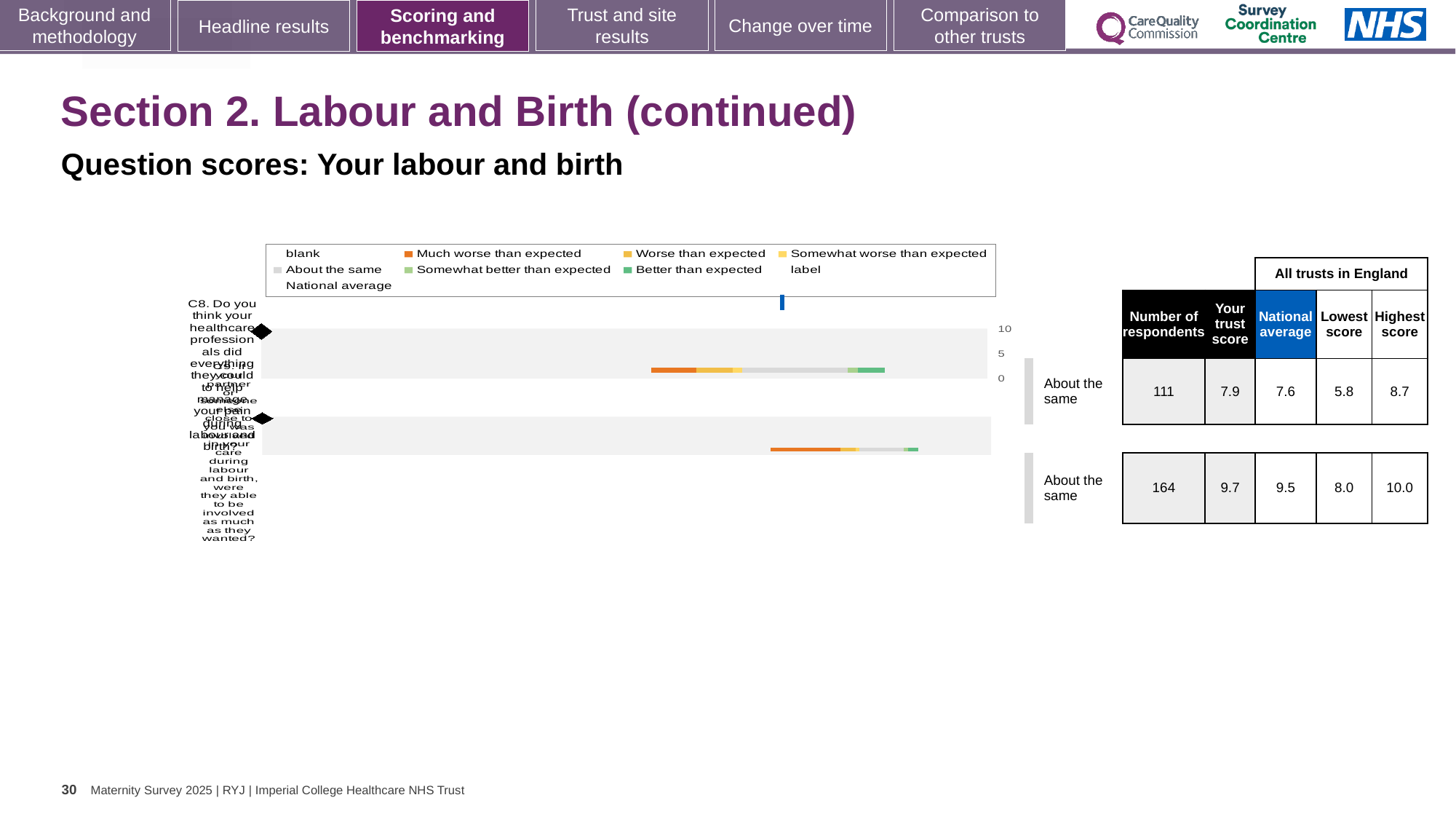
In the table beside the chart, what is the lowest score across all trusts for the first row (C8)? 5.8 In the table beside the chart, what is the number of respondents for the first row (C8, managing pain during labour and birth)? 111 In the chart legend, what colour represents 'Much worse than expected'? orange How many survey questions (bars) are plotted in the chart? 2 In the table beside the chart, what is 'Your trust score' for the first row (C8)? 7.9 What kind of chart is shown on the slide? bar chart For the second row (partner involvement), what is the difference between the highest score and the lowest score across all trusts in England? 2.0 Which row has the higher number of respondents? the second row (partner involvement), 164 In the table beside the chart, what is the national average for the second row (partner involvement in care)? 9.5 In the chart legend, what does the blue marker represent? National average What benchmark category is shown for both questions in the chart? About the same For the first row (C8), which is larger: 'Your trust score' or the national average? Your trust score